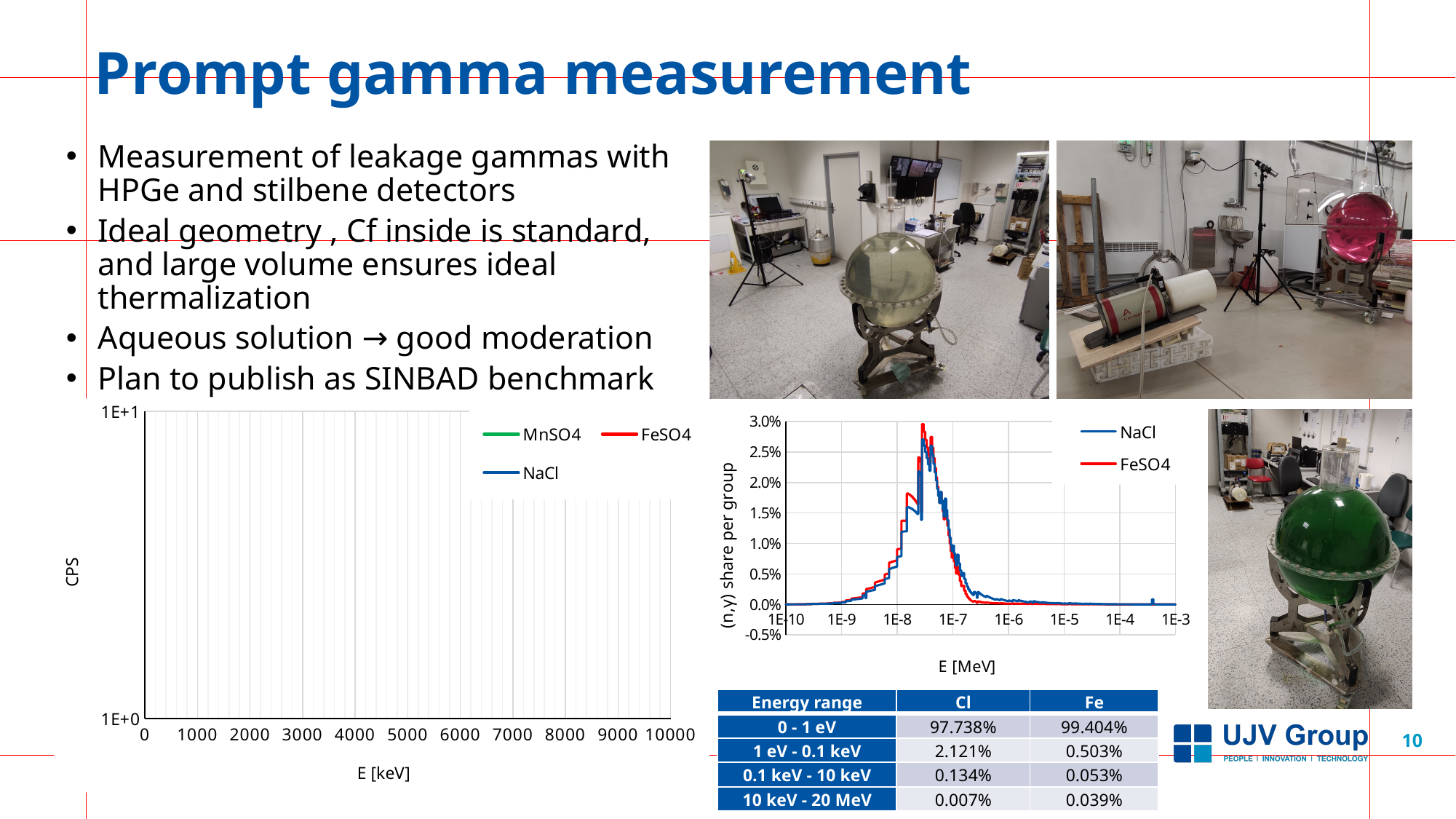
What is the x-axis label of the left chart (CPS chart)? E [keV] In the right chart ((n,γ) share per group), do the values rise or fall along the x axis between 1E-9 and 1E-8 MeV? rise In the right chart ((n,γ) share per group), which series reaches the higher peak, NaCl or FeSO4? FeSO4 How many series does the legend of the right chart ((n,γ) share per group vs E [MeV]) list? 2 What colour is the NaCl line in the right chart ((n,γ) share per group)? blue In the right chart ((n,γ) share per group), is the value of the NaCl series at 1E-5 MeV greater or less than 0.5%? less What is the highest value shown on the y axis of the right chart ((n,γ) share per group)? 3.0% How many series does the legend of the left chart (CPS vs E [keV]) list? 3 In the right chart ((n,γ) share per group), do the values rise or fall along the x axis between 1E-7 and 1E-6 MeV? fall What kind of chart is the right chart showing (n,γ) share per group? line chart In the right chart ((n,γ) share per group), is the peak value of the FeSO4 series greater or less than 2.5%? greater